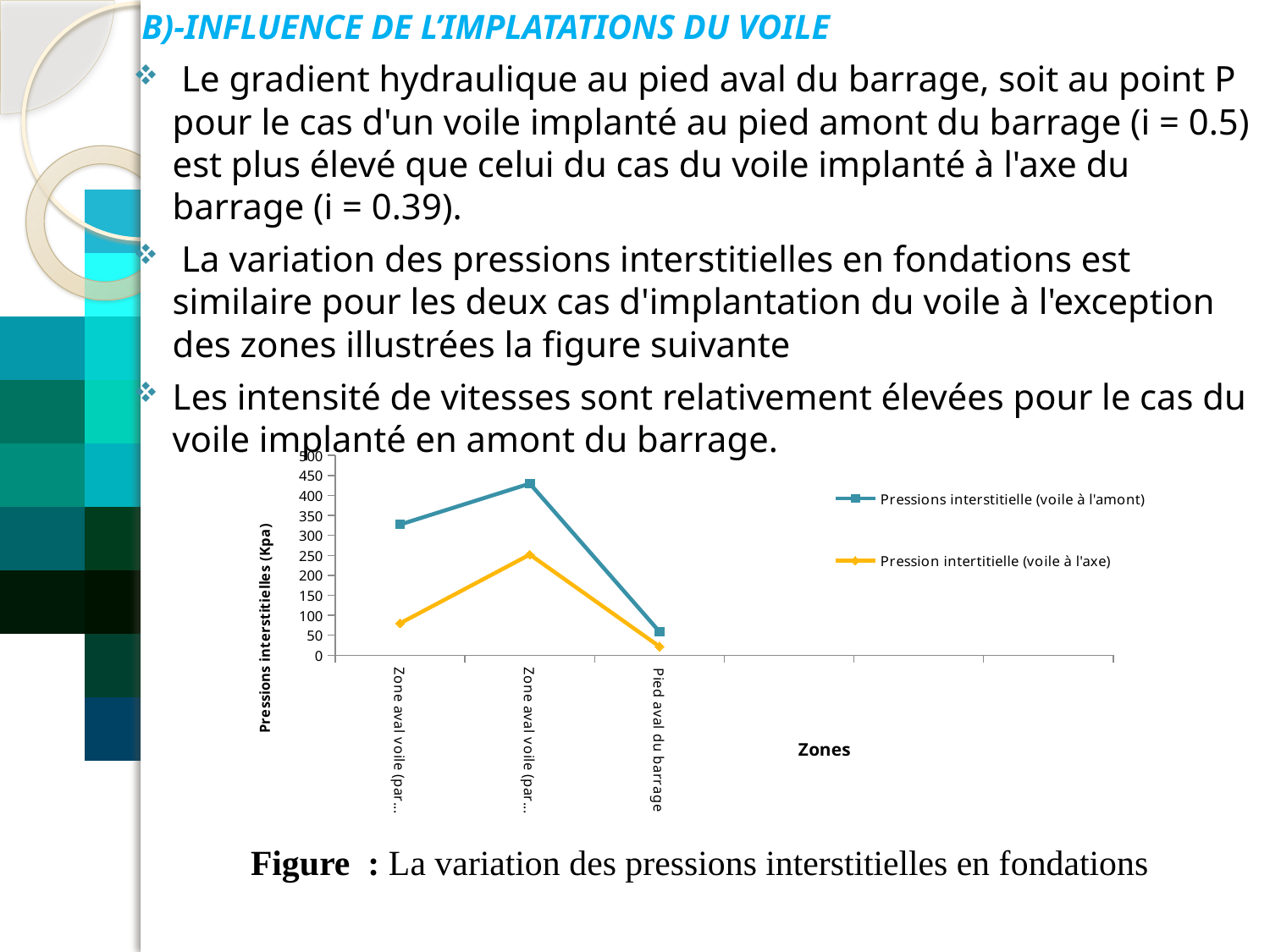
Is the value for Pied aval du barrage in the series Pressions interstitielle (voile à l'amont) greater or less than 100? less What kind of chart is shown on the slide? line chart Which category has the lowest value for the series Pression intertitielle (voile à l'axe)? Pied aval du barrage Which series is drawn in yellow in the chart? Pression intertitielle (voile à l'axe) What is the title of the y axis of the chart? Pressions interstitielles (Kpa) Do the values of the series Pression intertitielle (voile à l'axe) rise or fall between the second category and Pied aval du barrage? fall Is the value for Pied aval du barrage in the series Pression intertitielle (voile à l'axe) greater or less than 50? less Which category has the lowest value for the series Pressions interstitielle (voile à l'amont)? Pied aval du barrage How many series does the chart legend list? 2 Is the value of the second (middle) point of the series Pressions interstitielle (voile à l'amont) greater or less than 400? greater How many categories are plotted along the x axis of the chart? 3 At Pied aval du barrage, which series has the larger value: Pressions interstitielle (voile à l'amont) or Pression intertitielle (voile à l'axe)? Pressions interstitielle (voile à l'amont)